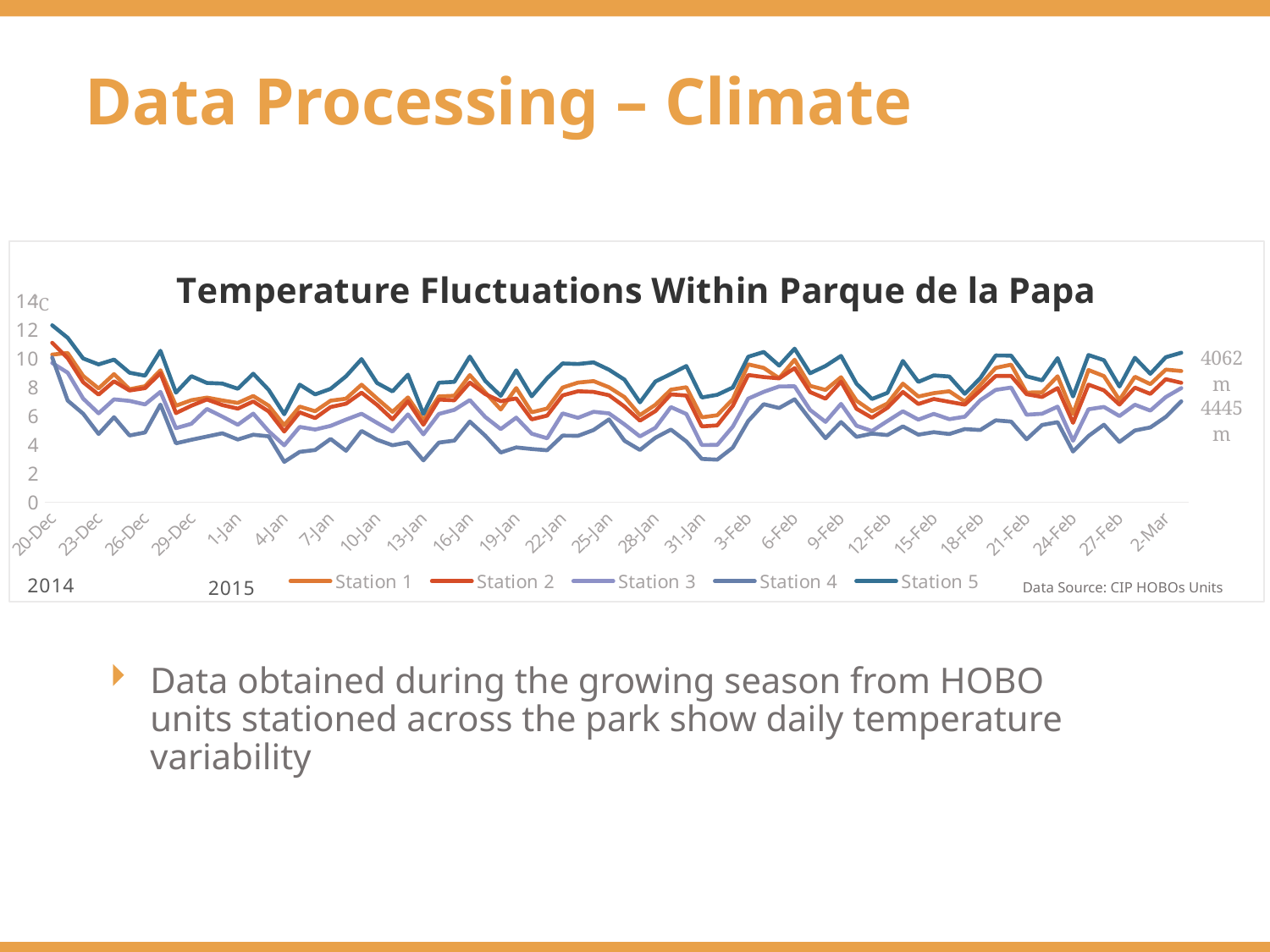
Which station's line is highest across the chart? Station 5 How many date labels are shown on the x axis? 25 What type of chart is shown on the slide? line chart How many series does the legend list? 5 Is the value for Station 5 on 4-Jan greater or less than 8? less On 20-Dec, which is larger: the value for Station 5 or the value for Station 4? Station 5 Does the Station 4 line rise or fall from 20-Dec to 4-Jan? fall What is the title of the chart? Temperature Fluctuations Within Parque de la Papa Is the value for Station 4 on 4-Jan greater or less than 4? less What data source is cited below the chart? CIP HOBOs Units Which station's line is lowest across the chart? Station 4 Is the value for Station 5 on 20-Dec greater or less than 10? greater